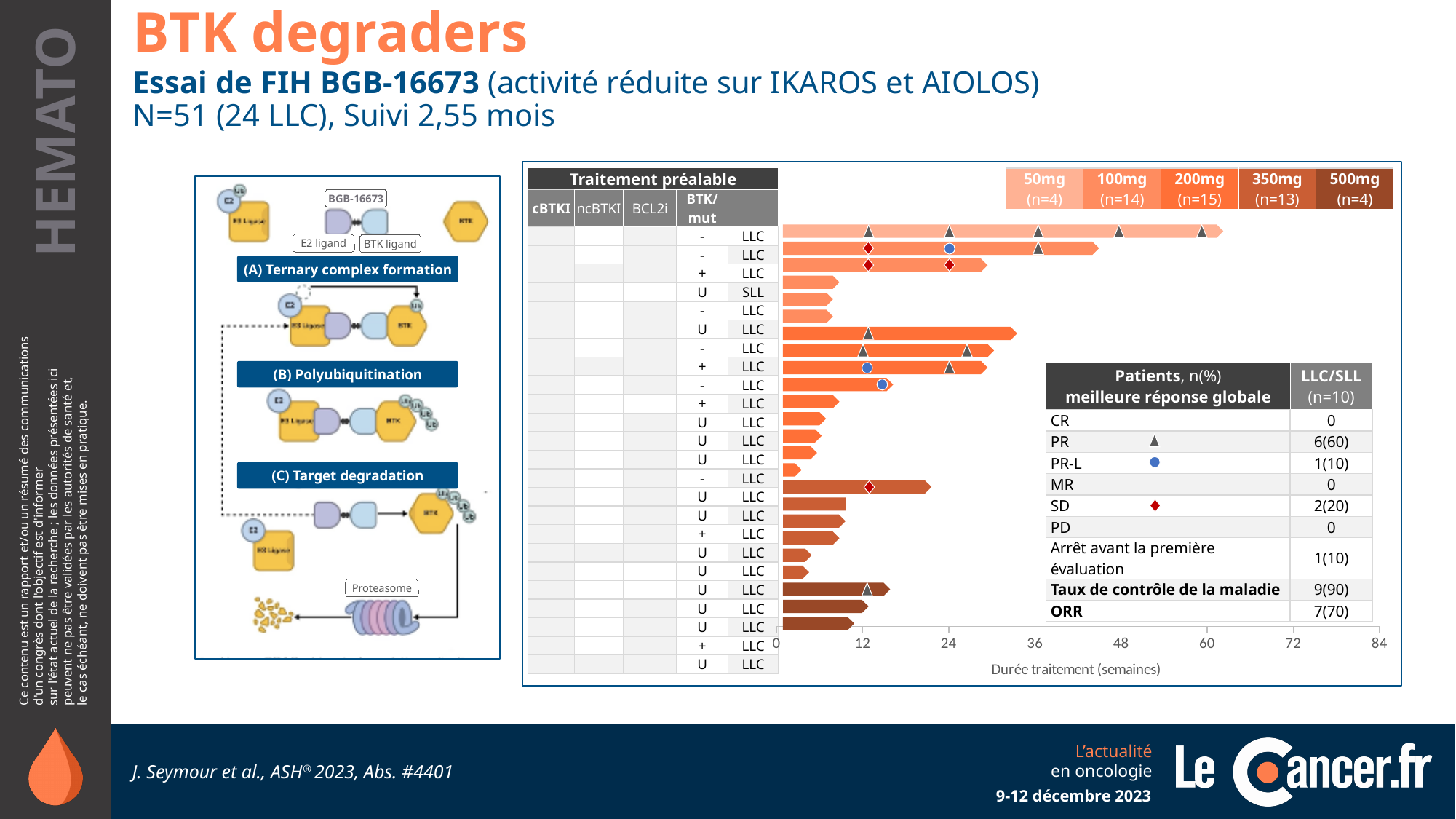
How many dose levels does the legend of the treatment-duration chart list? 5 Is the treatment duration of the longest 350mg bar (row 14, - LLC) greater or less than 12 weeks? greater How many patient rows (bars) are shown in the treatment-duration chart? 24 What is the maximum value shown on the x axis of the treatment-duration chart? 84 What kind of chart is used to show the treatment duration of each patient? bar chart Is the treatment duration of the second row (100mg, LLC) greater or less than 48 weeks? less What is the x-axis label of the treatment-duration chart? Durée traitement (semaines) Is the treatment duration of the longest bar (first row, 50mg) greater or less than 48 weeks? greater Which dose cohort has the longest treatment-duration bar in the chart? 50mg Which is longer in the treatment-duration chart: the first row (50mg) bar or the second row (100mg) bar? first row (50mg)